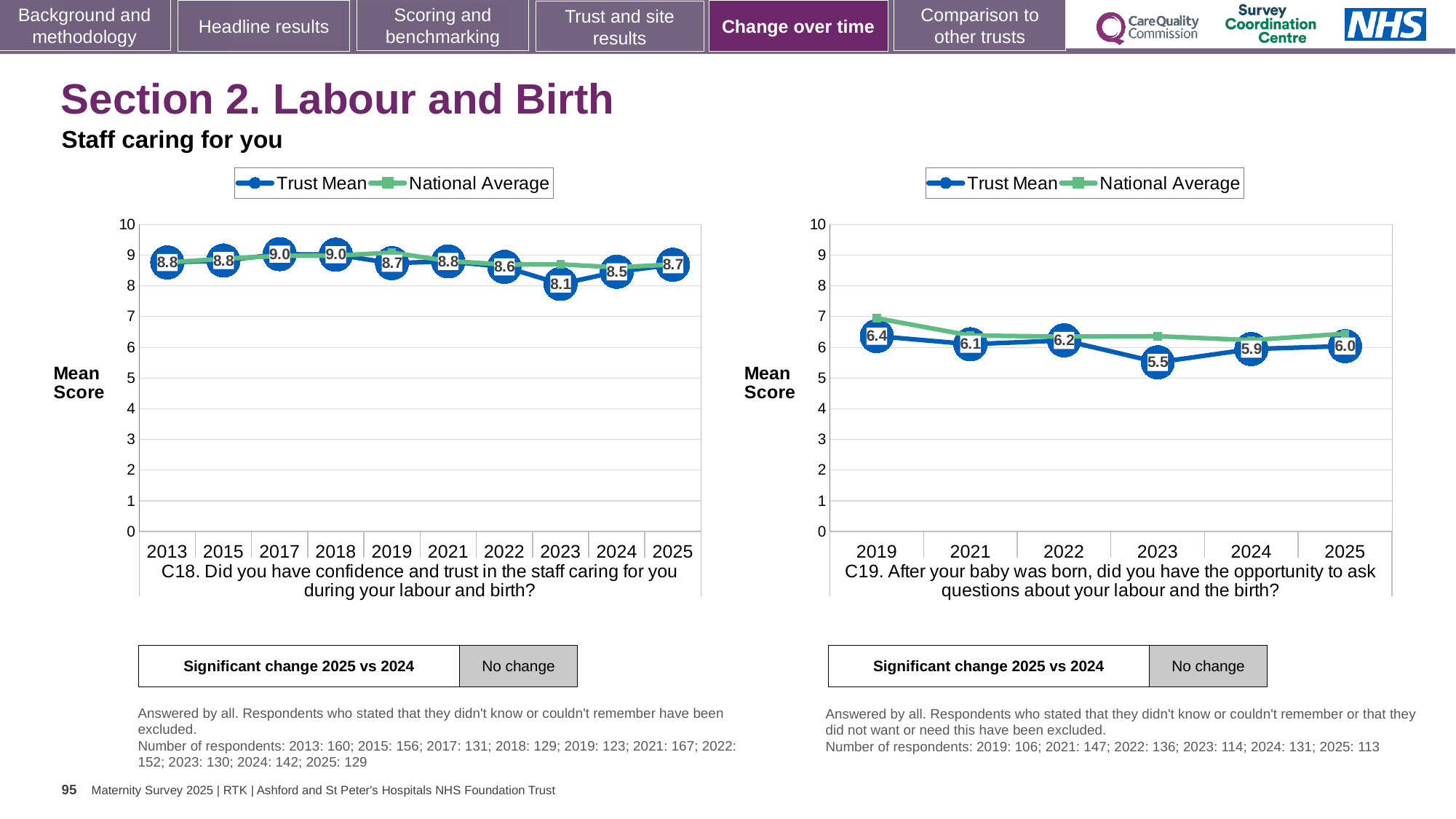
In the left chart (C18), is the Trust Mean score higher in 2024 or 2025? 2025 How many series does the legend of the right chart (C19) list? 2 In the left chart (C18), which year has the lowest Trust Mean score? 2023 What type of chart is used for C19 on the right? Line chart How many years are plotted on the x axis of the left chart (C18)? 10 In the right chart (C19), which year has the lowest Trust Mean score? 2023 In the right chart (C19), is the National Average value for 2019 greater or less than 6? greater In the left chart (C18), what is the difference between the Trust Mean scores for 2018 and 2023? 0.9 In the right chart (C19), what is the difference between the Trust Mean scores for 2019 and 2023? 0.9 In the right chart (C19), which year has the highest Trust Mean score? 2019 In the left chart (C18), what is the Trust Mean score for 2023? 8.1 In the right chart (C19), what is the Trust Mean score for 2025? 6.0